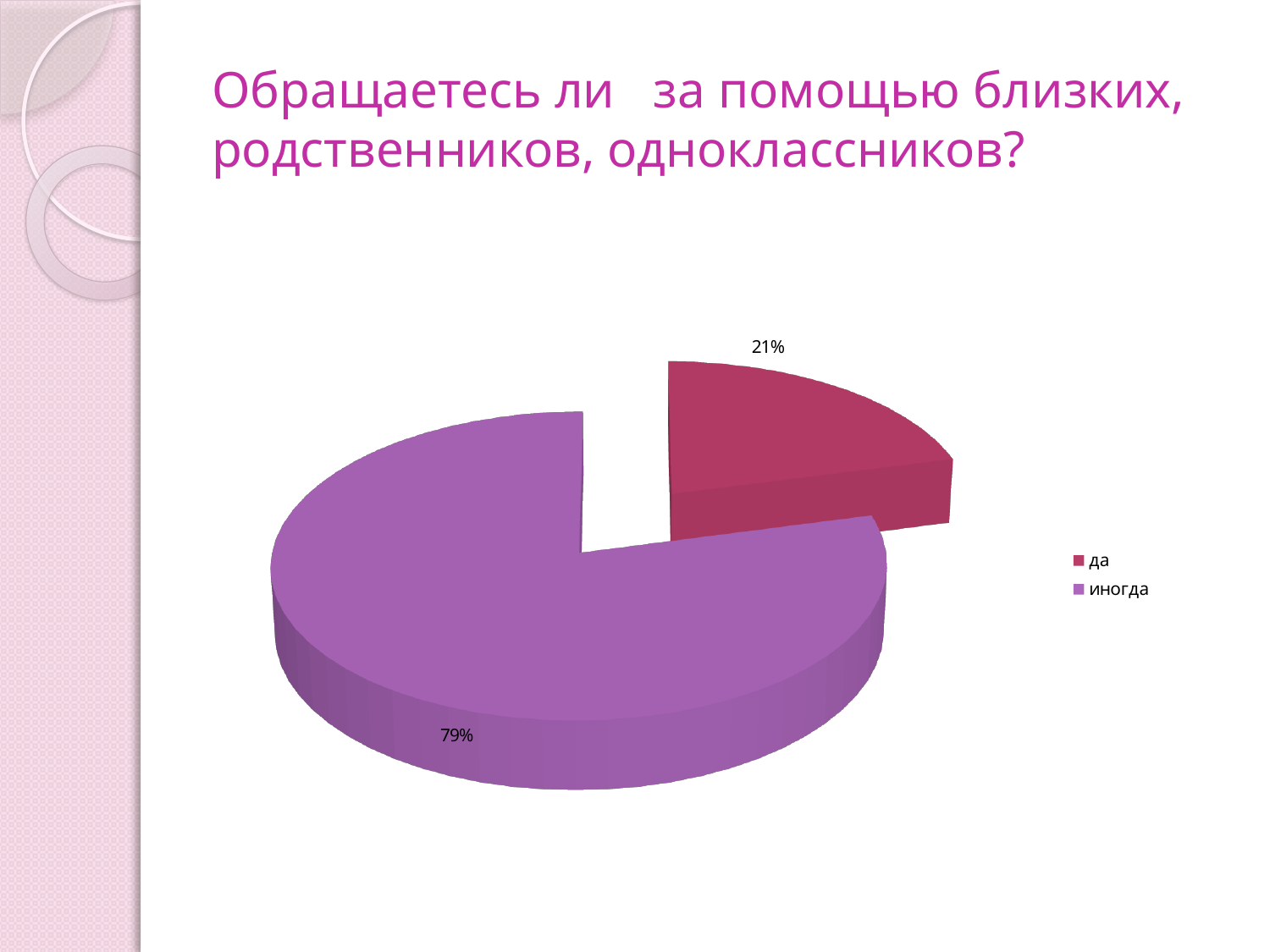
What share of the pie does the "да" slice represent? 21% Which slice is larger, "да" or "иногда"? иногда What kind of chart is shown on the slide? pie chart What is the difference in percentage points between the "иногда" and "да" slices? 58 Which category has the smallest slice of the pie? да What share of the pie does the "иногда" slice represent? 79% What is the title of the slide? Обращаетесь ли за помощью близких, родственников, одноклассников? What colour is the "да" slice? red How many entries does the legend list? 2 How many slices does the pie chart have? 2 Which category has the largest slice of the pie? иногда